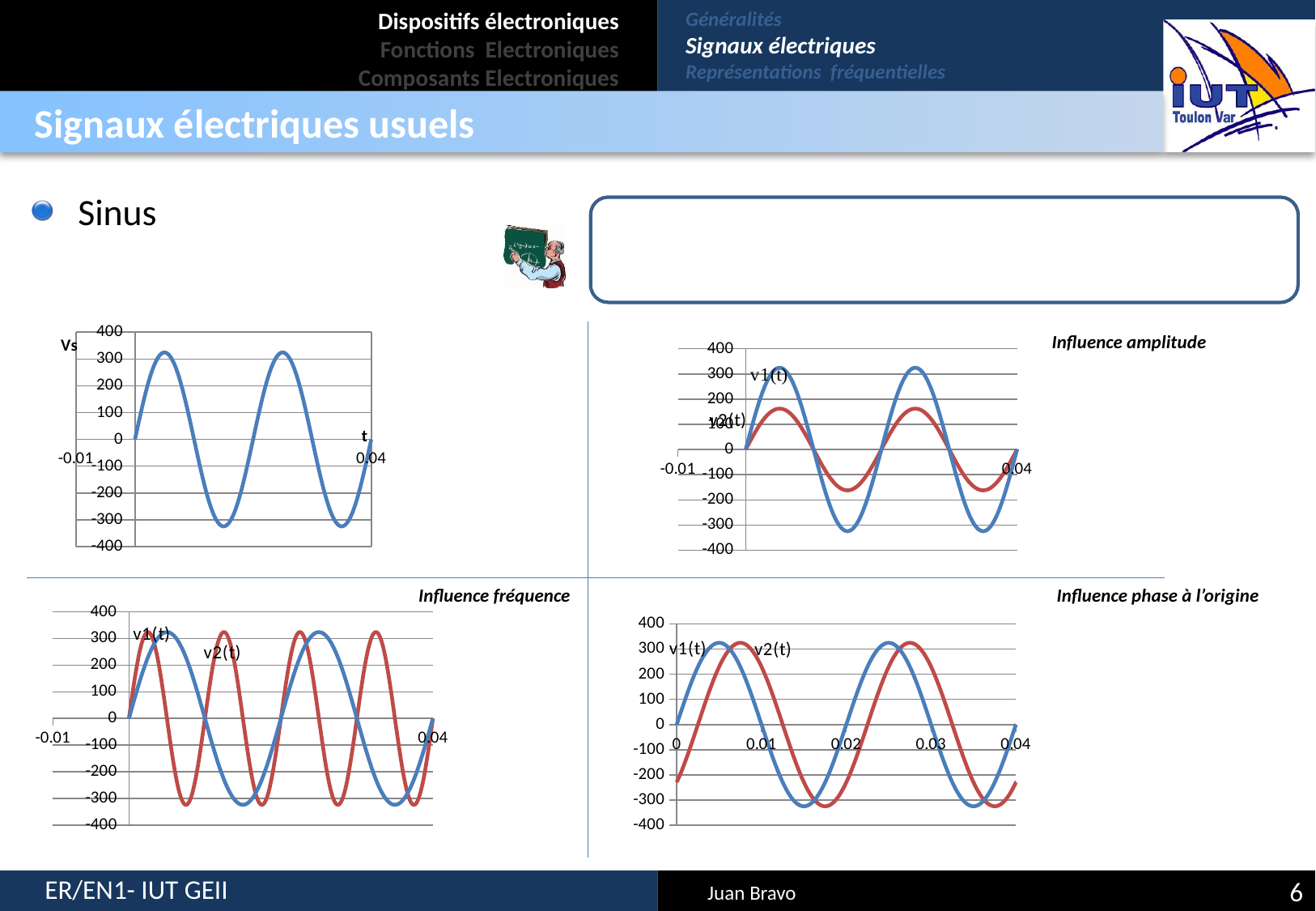
In the 'Influence amplitude' chart, is the peak value of v1(t) greater or less than 300? greater In the top-left chart labelled Vs, is the maximum value of the signal greater or less than 400? less In the top-left chart labelled Vs, is the minimum value of the signal greater or less than -300? less How many charts are shown on the slide? 4 In the 'Influence phase à l'origine' chart, what colour is the line for v2(t)? red In the 'Influence amplitude' chart, which signal has the larger peak value, v1(t) or v2(t)? v1(t) In the 'Influence fréquence' chart, which signal has the higher frequency, v1(t) or v2(t)? v2(t) What is the last value shown on the horizontal axis of the 'Influence fréquence' chart? 0.04 In the 'Influence amplitude' chart, how many signals are plotted? 2 What kind of chart is the top-left chart labelled Vs? line chart What is the highest value shown on the vertical axis of the 'Influence phase à l'origine' chart? 400